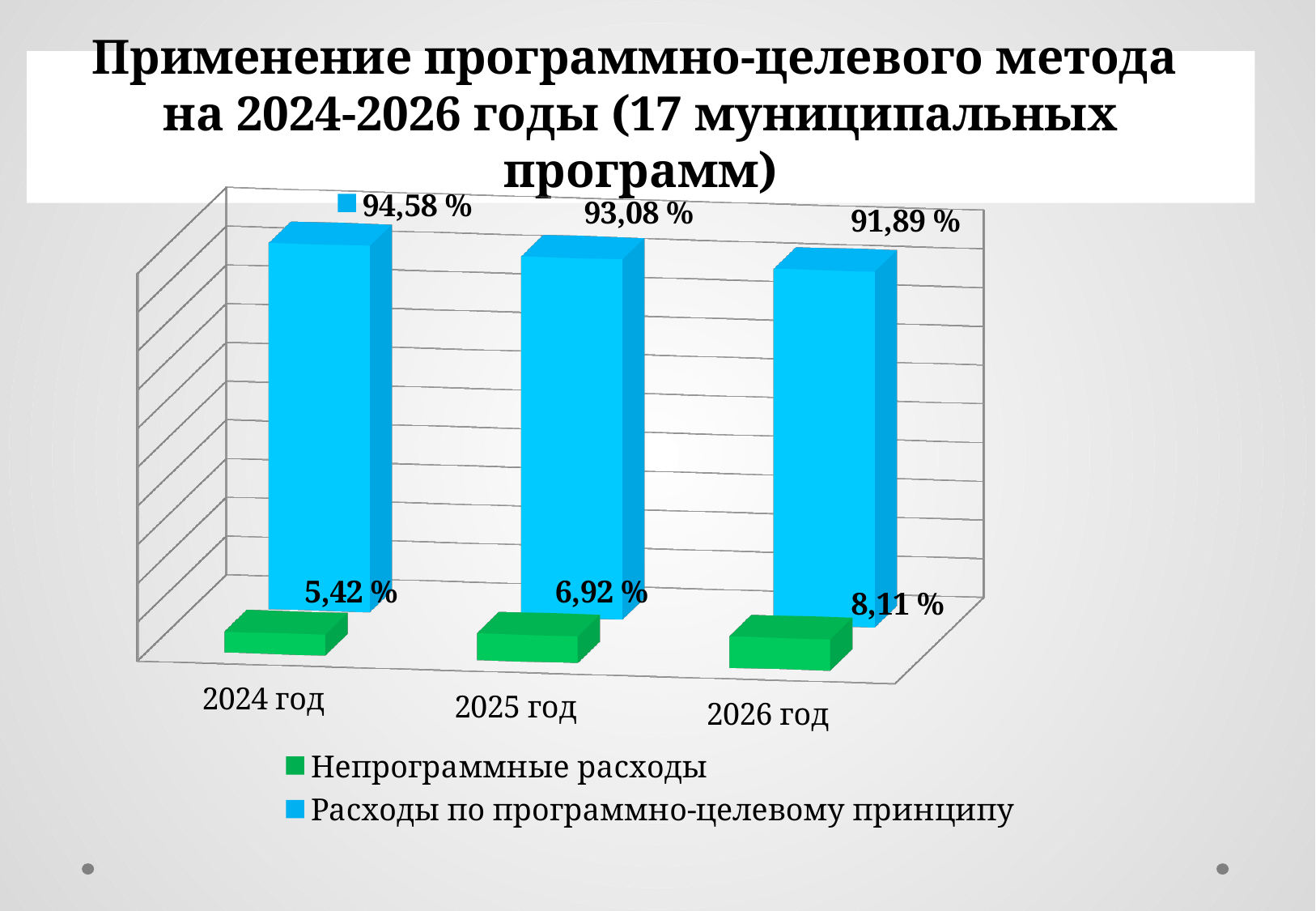
How many series does the legend list? 2 What kind of chart is shown on the slide? Bar chart In which year is Расходы по программно-целевому принципу highest? 2024 год What is the value for Непрограммные расходы in 2025 год? 6,92 % Do the values for Расходы по программно-целевому принципу rise or fall from 2024 год to 2026 год? Fall How many years are shown on the x axis? 3 What is the value for Непрограммные расходы in 2026 год? 8,11 % What is the value for Расходы по программно-целевому принципу in 2024 год? 94,58 % Which is larger: Непрограммные расходы in 2025 год or in 2026 год? 2026 год What is the value for Расходы по программно-целевому принципу in 2026 год? 91,89 % In which year is Непрограммные расходы lowest? 2024 год What is the difference between Расходы по программно-целевому принципу in 2024 год and 2026 год? 2,69 %